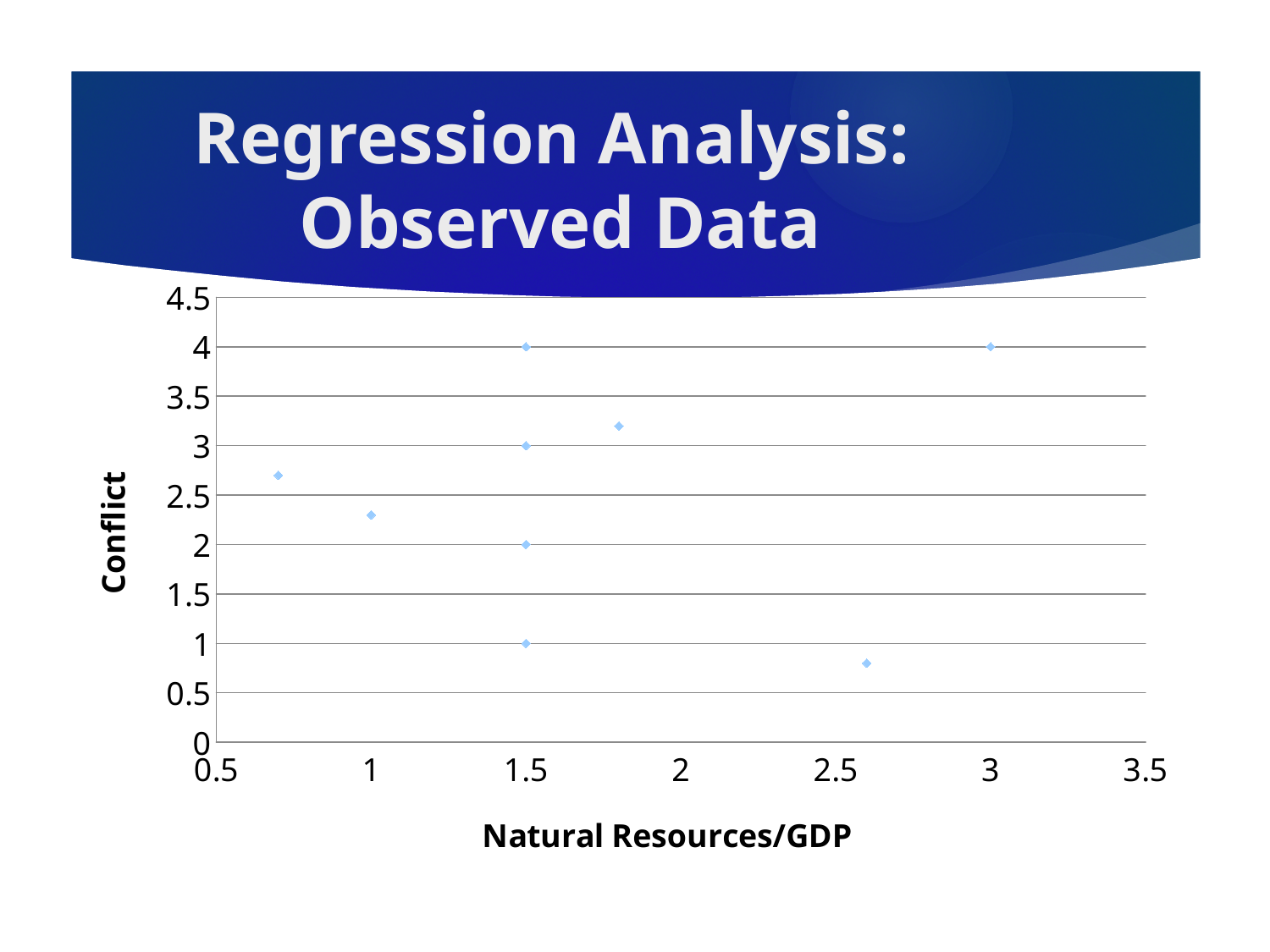
What is the lowest Conflict value among the points plotted at Natural Resources/GDP = 1.5? 1 Is the Conflict value for the point at Natural Resources/GDP of about 0.7 greater or less than 2.5? greater Is the Conflict value for the point at Natural Resources/GDP = 1 greater or less than 2.5? less Which point has the lower Conflict value: the one at Natural Resources/GDP of about 1.8 or the one at about 2.6? the one at about 2.6 What is the title of the y axis? Conflict How many data points are plotted at a Natural Resources/GDP value of 1.5? 4 Is the Conflict value for the point at Natural Resources/GDP of about 2.6 greater or less than 1? less What is the Conflict value of the point plotted at Natural Resources/GDP = 3? 4 What is the highest Conflict value reached by any point on the chart? 4 What is the title of the x axis? Natural Resources/GDP What kind of chart is shown on the slide? scatter chart How many data points are plotted on the chart? 9